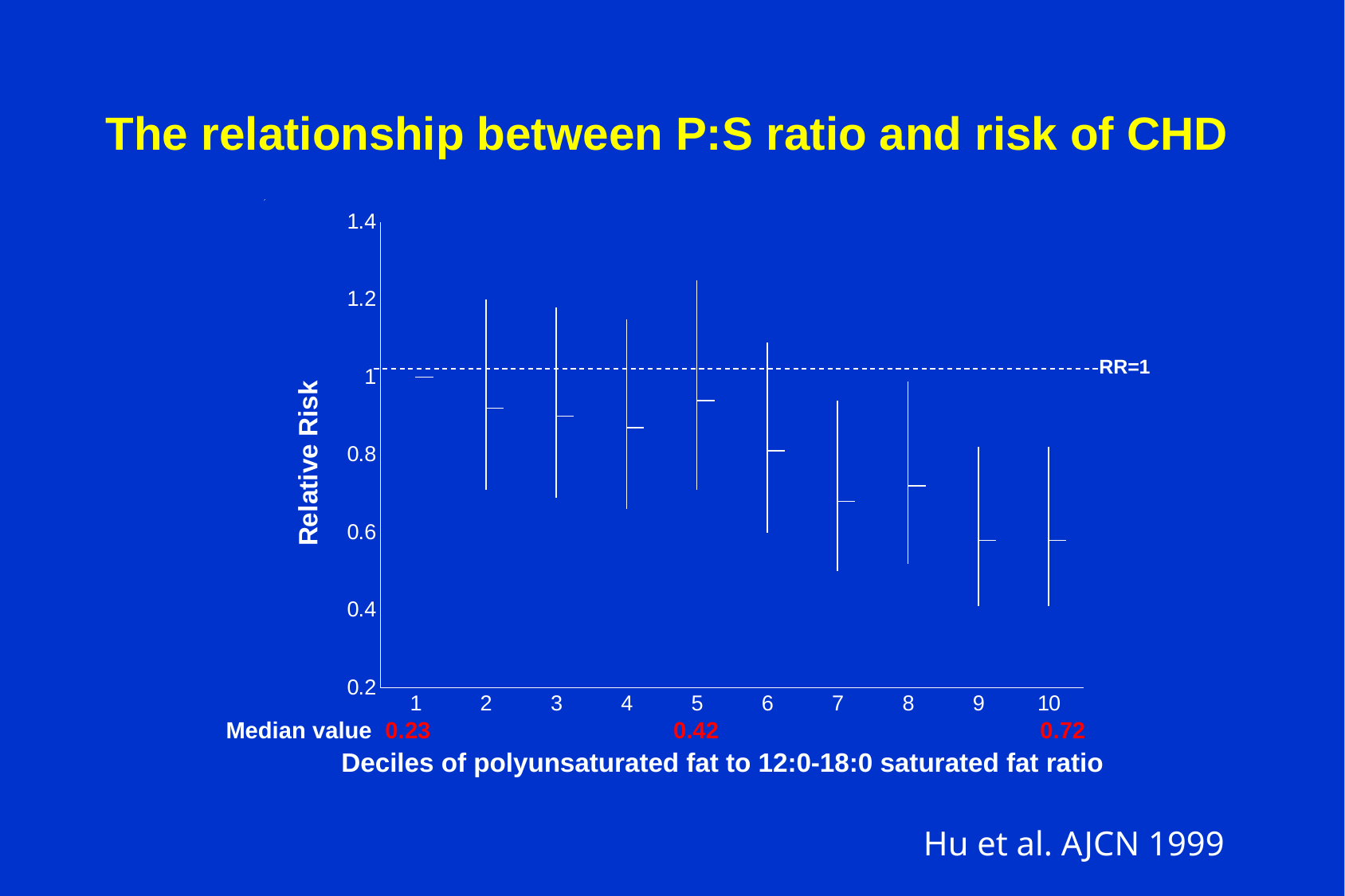
Which decile has the highest relative risk? 1 What is the title of the chart on the slide? The relationship between P:S ratio and risk of CHD Is the relative risk for decile 7 greater or less than 0.8? less How many deciles are plotted along the x axis? 10 What is the median value printed for decile 5? 0.42 Which has the larger relative risk, decile 5 or decile 9? decile 5 Is the relative risk for decile 2 greater or less than 1? less Does relative risk generally rise or fall as the decile increases from 1 to 10? fall What is the median value printed for decile 10? 0.72 What is the label of the y axis? Relative Risk What is the median value printed for decile 1? 0.23 What is the relative risk for decile 1? 1